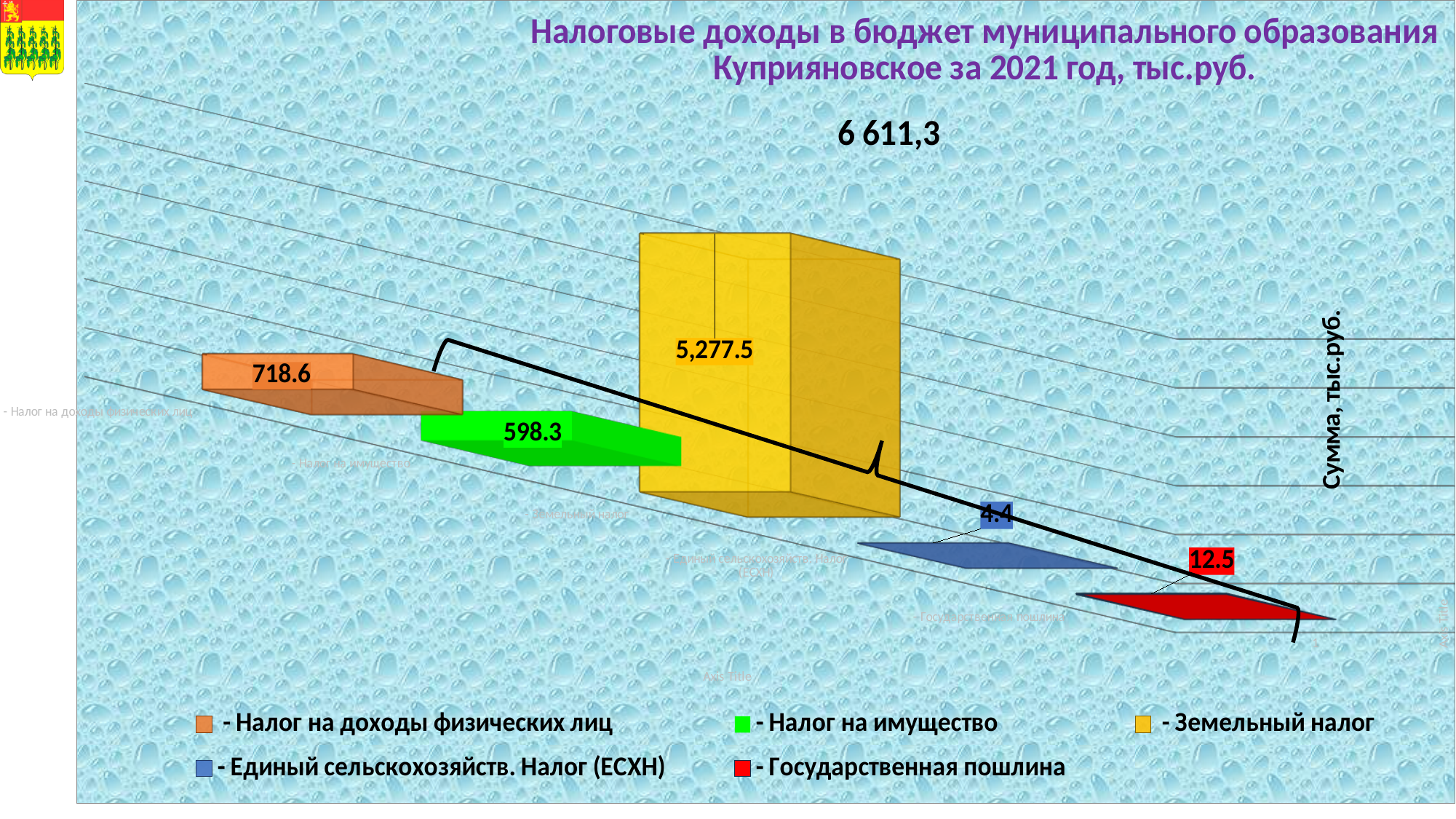
What is the value for Единый сельскохозяйств. Налог (ЕСХН)? 4.4 What is the value for Налог на имущество? 598.3 What kind of chart is shown on the slide? Bar chart Which category has the lowest value? Единый сельскохозяйств. Налог (ЕСХН) What is the value for Налог на доходы физических лиц? 718.6 How many categories are shown in the chart? 5 What is the difference between Налог на доходы физических лиц and Налог на имущество? 120.3 Which category has the highest value? Земельный налог Which is larger, Государственная пошлина or Единый сельскохозяйств. Налог (ЕСХН)? Государственная пошлина What is the value for Государственная пошлина? 12.5 What is the value for Земельный налог? 5,277.5 What total amount is printed above the chart? 6 611,3